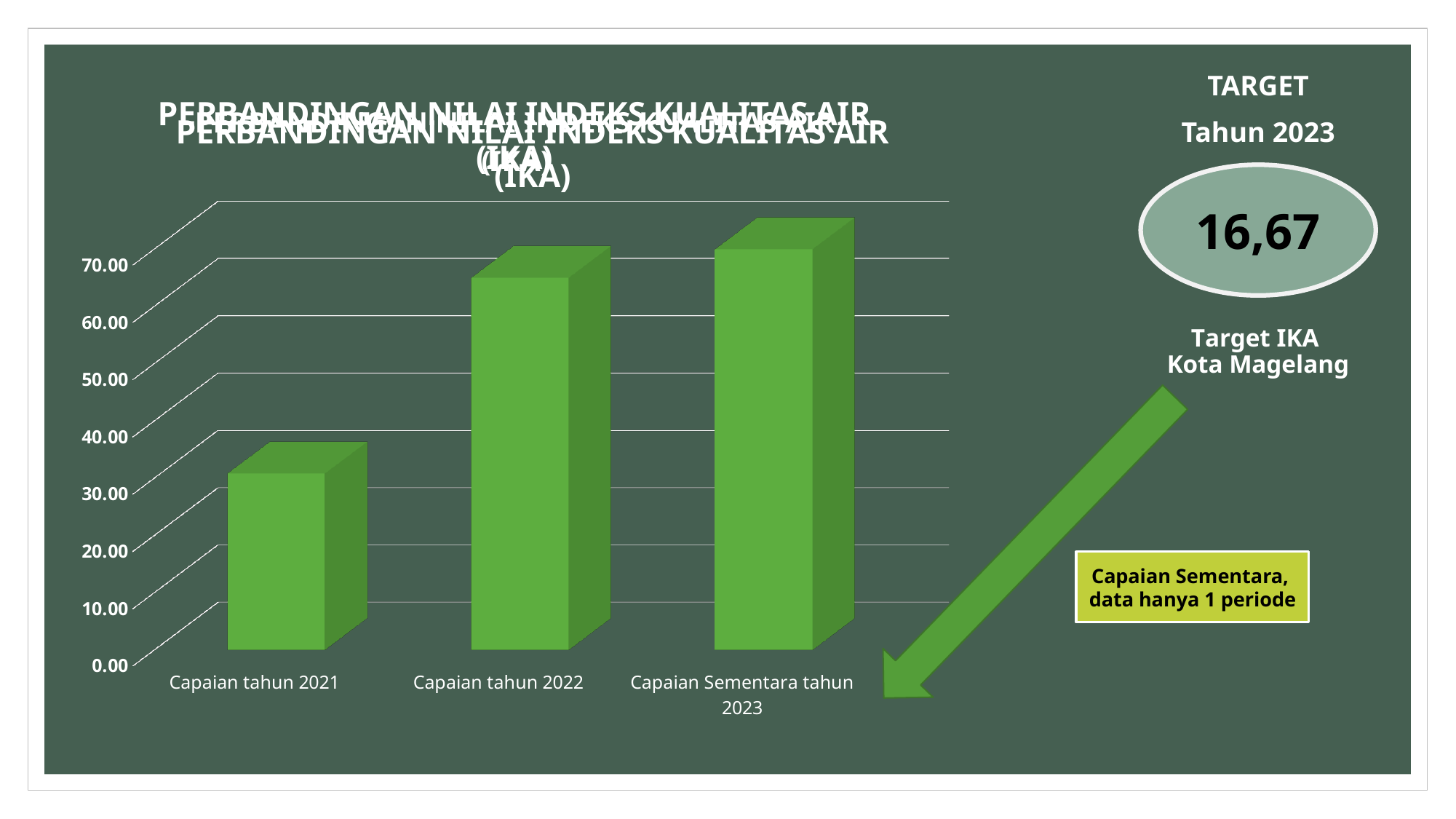
Is the value for Capaian tahun 2022 greater or less than 60? greater Which is larger, the value for Capaian tahun 2021 or the value for Capaian tahun 2022? Capaian tahun 2022 Is the value for Capaian tahun 2021 greater or less than 40? less Do the values rise or fall from Capaian tahun 2021 to Capaian Sementara tahun 2023? rise What kind of chart is shown on the slide? bar chart How many bars (categories) does the chart show? 3 Is the value for Capaian Sementara tahun 2023 greater or less than 60? greater Which category has the lowest value in the chart? Capaian tahun 2021 Which category has the highest value in the chart? Capaian Sementara tahun 2023 What is the title of the chart? PERBANDINGAN NILAI INDEKS KUALITAS AIR (IKA) What is the highest value labelled on the vertical axis of the chart? 70.00